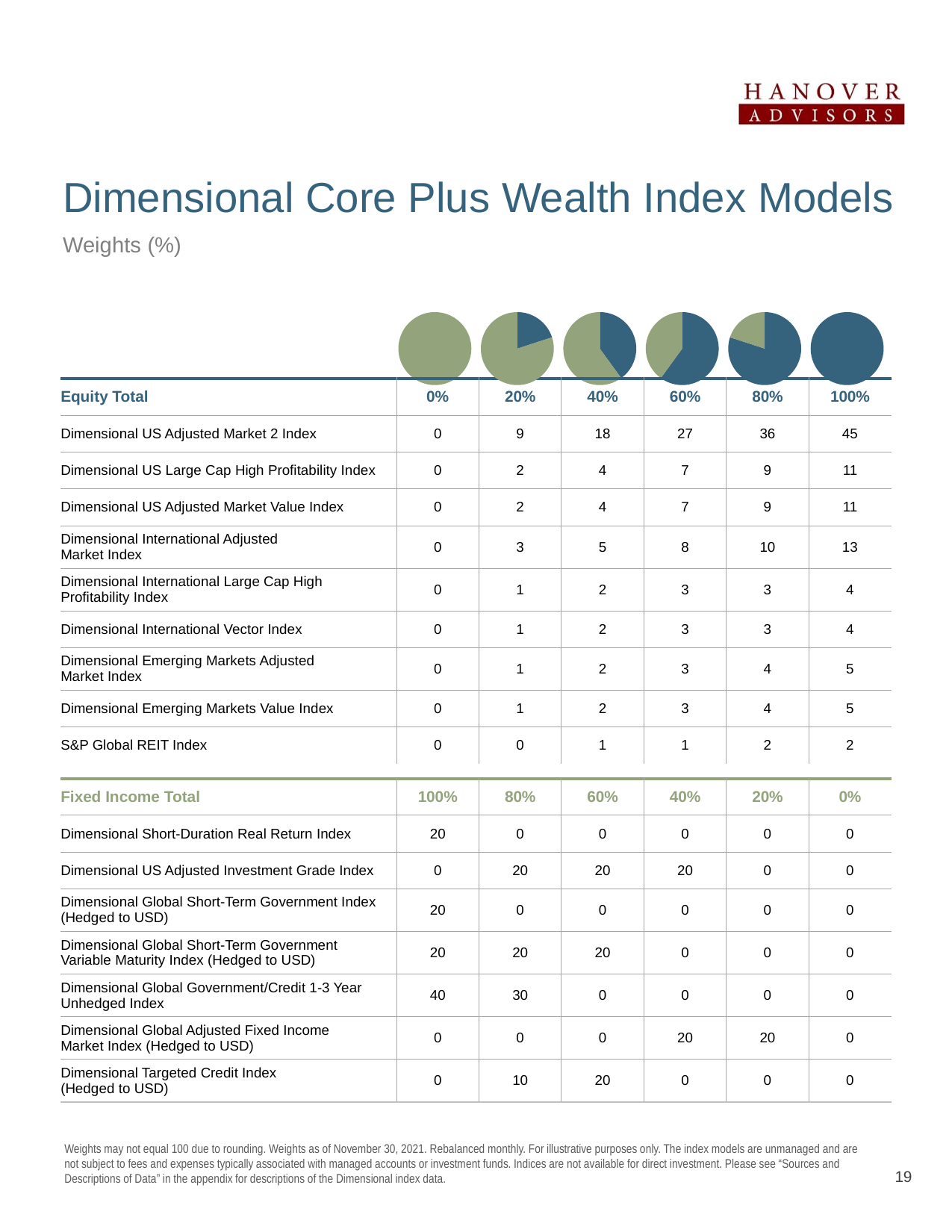
In the leftmost pie chart, what share is Fixed Income Total? 100% In the third pie chart from the left, what share is Fixed Income Total? 60% In the rightmost pie chart, what share is Equity Total? 100% How many pie charts are shown above the table? 6 In the second pie chart from the left, which is larger, the Equity Total share or the Fixed Income Total share? Fixed Income Total Does the Equity Total share rise or fall across the pie charts from left to right? Rise Which colour represents Equity Total in the pie charts? Blue What kind of charts are shown above the table on the slide? Pie charts